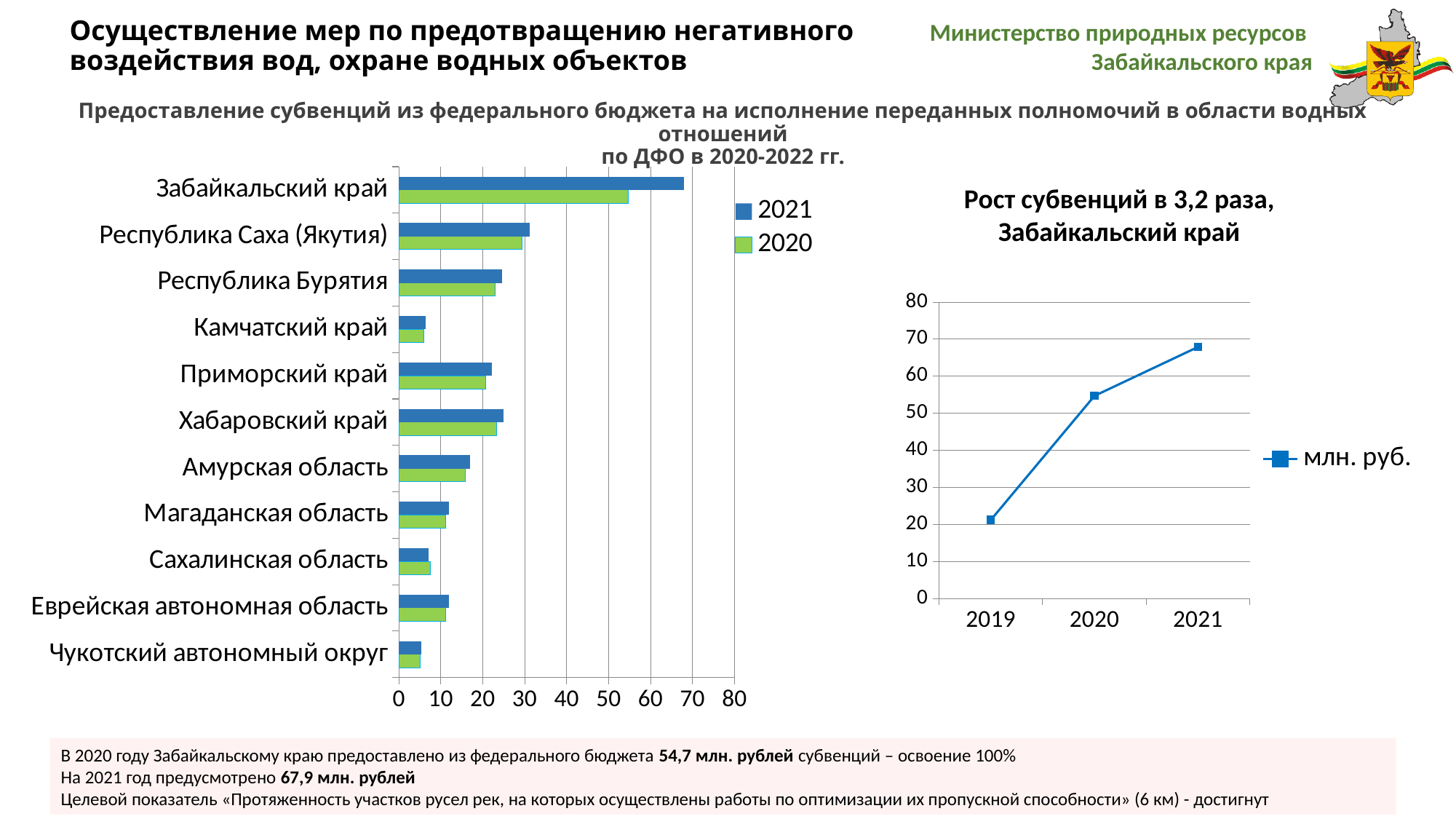
In the left bar chart, which colour represents the 2020 series? green In the right line chart, do the values rise or fall from 2019 to 2021? rise In the left bar chart, is the 2021 value for Республика Саха (Якутия) greater or less than 40? less In the left bar chart, which has the larger 2021 value: Республика Бурятия or Камчатский край? Республика Бурятия In the left bar chart, is the 2021 value for Забайкальский край greater or less than 60? greater In the left bar chart, which region has the highest value for 2021? Забайкальский край What kind of chart is the left chart titled «Предоставление субвенций из федерального бюджета...»? bar chart In the left bar chart, which has the larger 2021 value: Хабаровский край or Амурская область? Хабаровский край In the right line chart, is the value for 2019 greater or less than 30? less In the left bar chart, how many series does the legend list? 2 In the left bar chart, how many regions are listed on the vertical axis? 11 What kind of chart is the right chart titled «Рост субвенций в 3,2 раза, Забайкальский край»? line chart